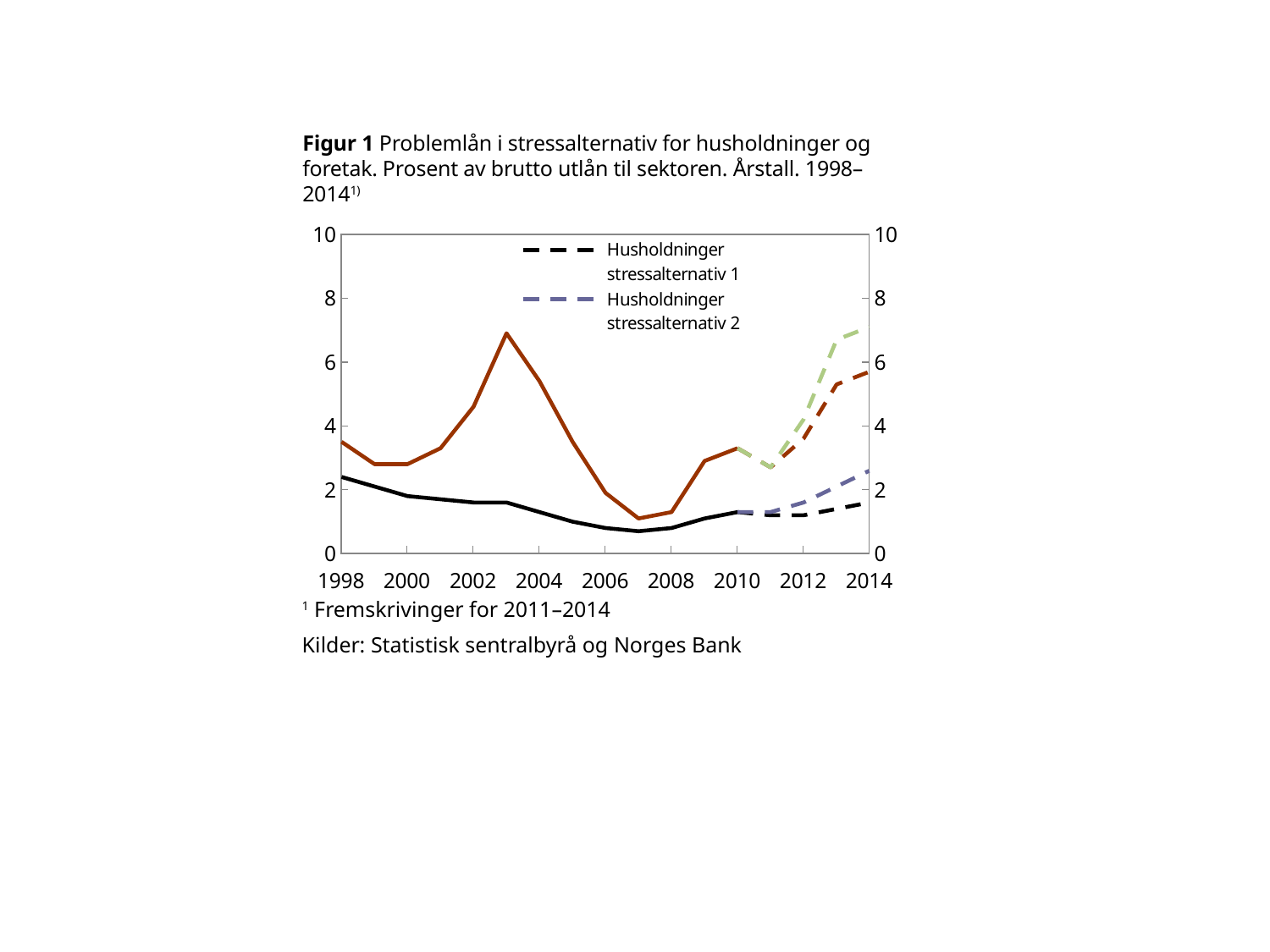
In 2014, which is higher: Husholdninger stressalternativ 1 or Husholdninger stressalternativ 2? Husholdninger stressalternativ 2 In which year does the solid brown line reach its highest value? 2003 Does the solid black line rise or fall from 1998 to 2007? fall Is the peak value of the solid brown line greater or less than 6? greater Is the value of Husholdninger stressalternativ 1 in 2014 greater or less than 2? less Is the value of the solid black line in 2007 greater or less than 2? less What is the title of the chart? Figur 1 Problemlån i stressalternativ for husholdninger og foretak. Prosent av brutto utlån til sektoren. Årstall. 1998–2014 What kind of chart is shown on the slide? line chart Which two series are named in the legend? Husholdninger stressalternativ 1 and Husholdninger stressalternativ 2 How many series does the legend list? 2